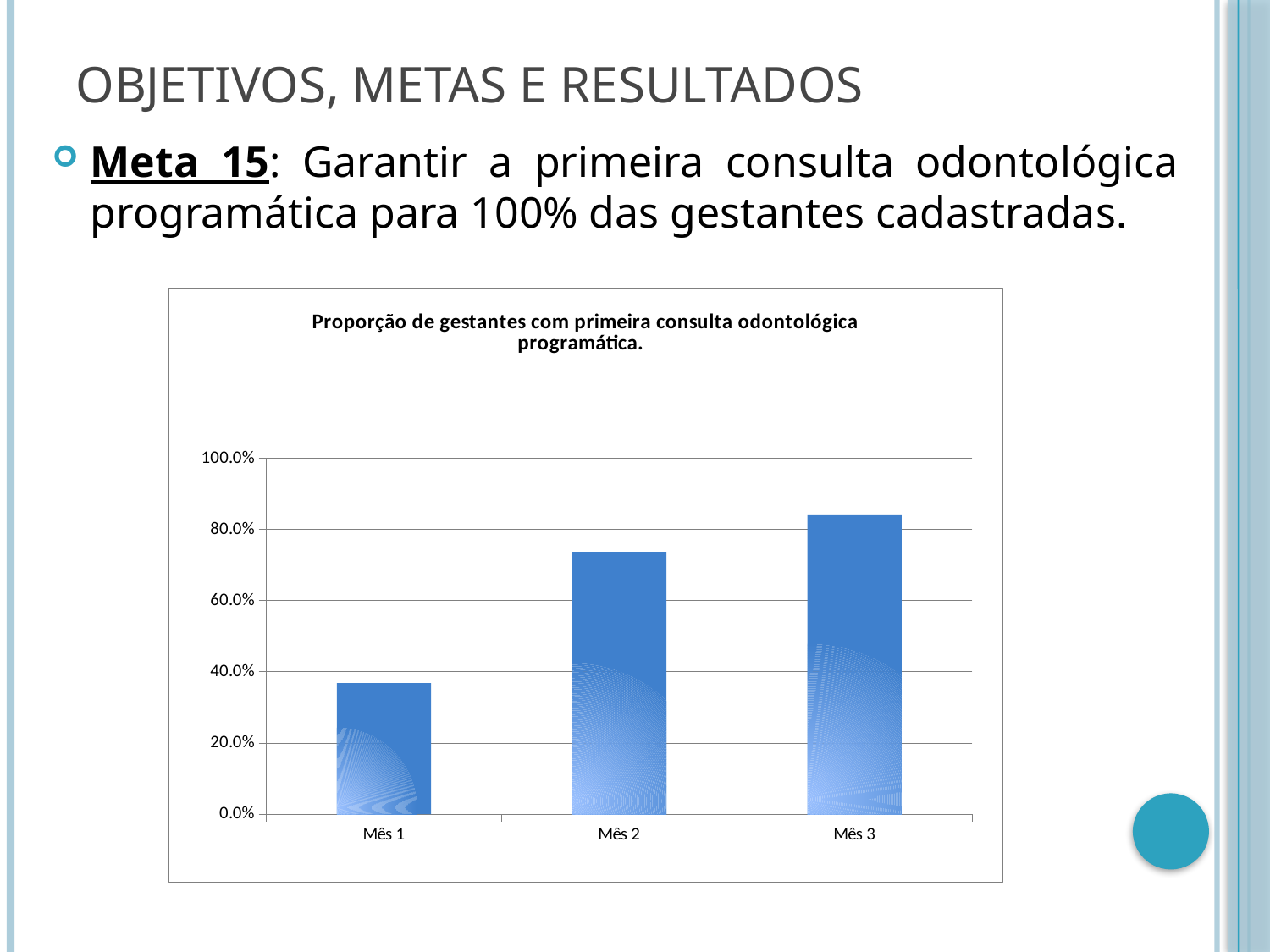
Do the values rise or fall from Mês 1 to Mês 3? rise Which is larger, the value for Mês 2 or the value for Mês 3? Mês 3 What kind of chart is shown on the slide? bar chart Which month has the lowest proportion in the chart? Mês 1 Is the value for Mês 1 greater or less than 40.0%? less Is the value for Mês 3 greater or less than 100.0%? less Which month has the highest proportion in the chart? Mês 3 Which is larger, the value for Mês 1 or the value for Mês 2? Mês 2 What is the title of the chart? Proporção de gestantes com primeira consulta odontológica programática. How many categories are shown on the x axis of the chart? 3 Is the value for Mês 3 greater or less than 80.0%? greater